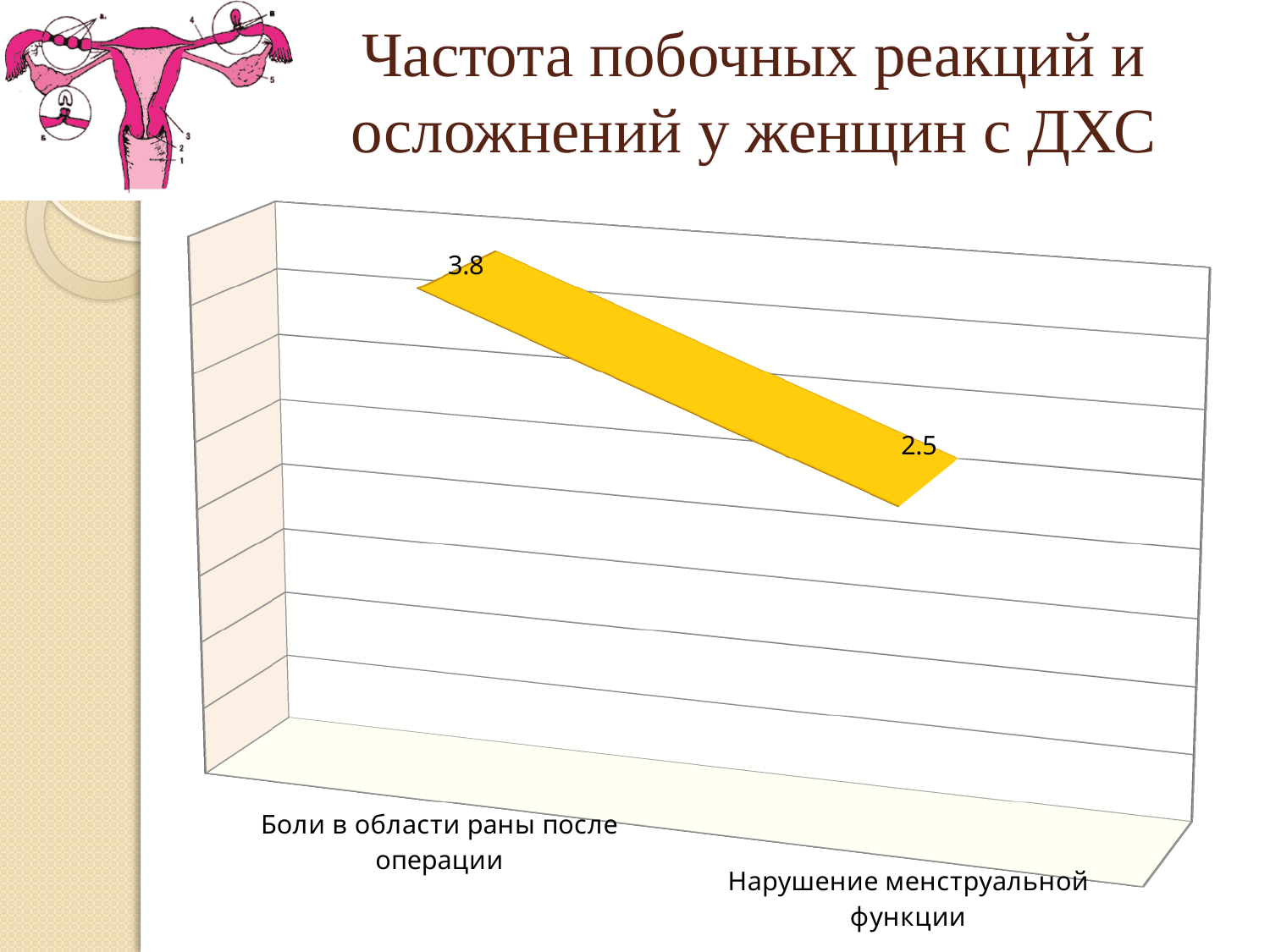
What is the difference between the values for 'Боли в области раны после операции' and 'Нарушение менструальной функции'? 1.3 How many categories are shown on the chart? 2 What is the title of the slide containing the chart? Частота побочных реакций и осложнений у женщин с ДХС What colour is the plotted area on the chart? yellow Which is larger: the value for 'Боли в области раны после операции' or for 'Нарушение менструальной функции'? Боли в области раны после операции Which category has the lowest value? Нарушение менструальной функции What kind of chart is shown on the slide? 3D line chart Which category has the highest value? Боли в области раны после операции What is the value for 'Нарушение менструальной функции'? 2.5 Do the values rise or fall from the first category to the second? fall What is the value for 'Боли в области раны после операции'? 3.8